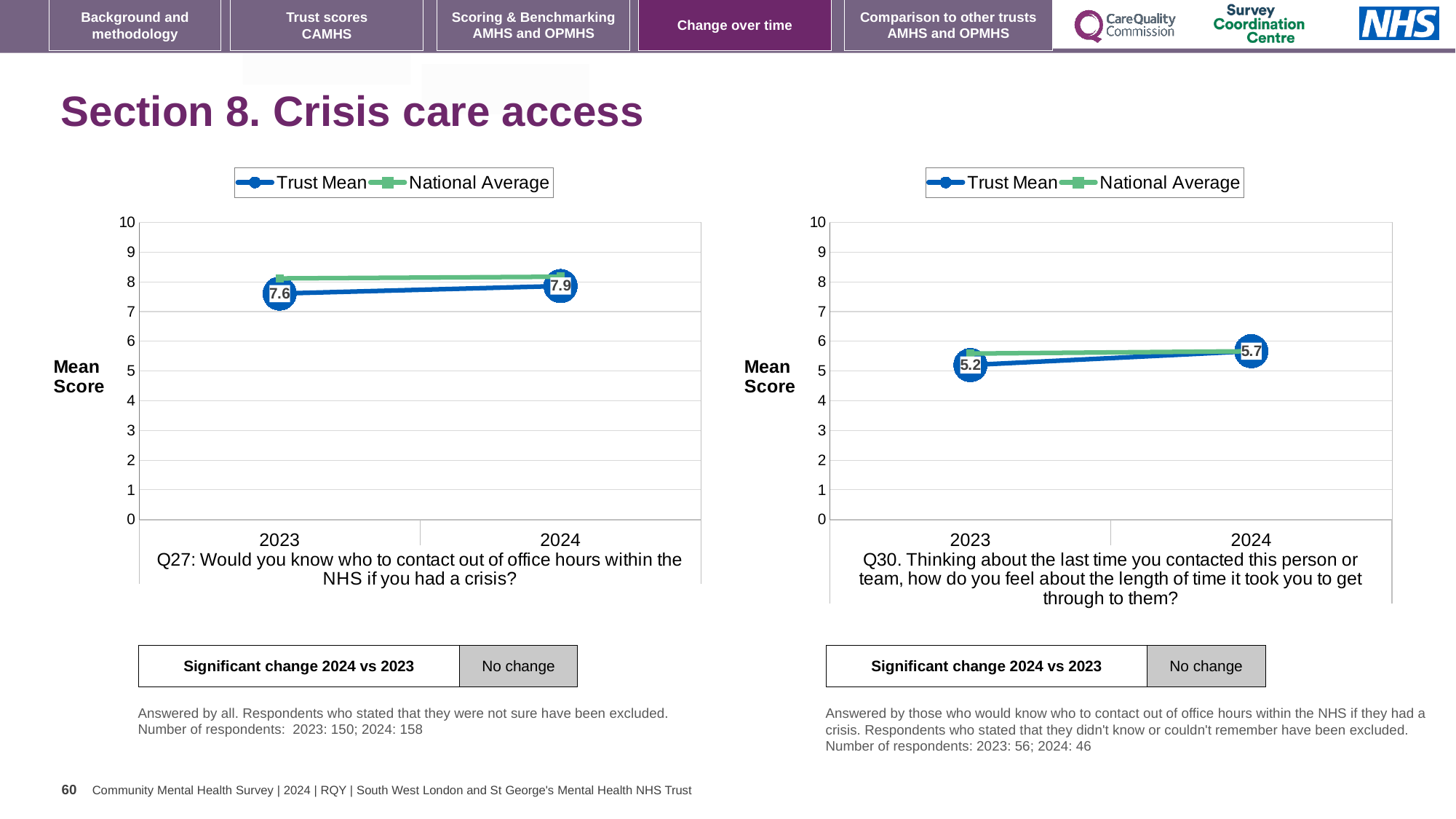
In the Q27 chart (left), is the National Average for 2023 greater or less than 7? greater In the Q27 chart (left), does the Trust Mean rise or fall from 2023 to 2024? rise In the Q30 chart (right), is the Trust Mean for 2023 greater or less than 6? less How many series does the legend of the Q30 chart (right) list? 2 In the Q27 chart (left), what is the Trust Mean score for 2024? 7.9 In the Q30 chart (right), by how much did the Trust Mean change from 2023 to 2024? 0.5 What is the label of the y axis on the Q27 chart (left)? Mean Score What kind of chart is the Q27 chart (left)? line chart In the Q27 chart (left), what is the Trust Mean score for 2023? 7.6 In the Q30 chart (right), what is the Trust Mean score for 2024? 5.7 In the Q27 chart (left), by how much did the Trust Mean change from 2023 to 2024? 0.3 In the Q30 chart (right), what is the Trust Mean score for 2023? 5.2